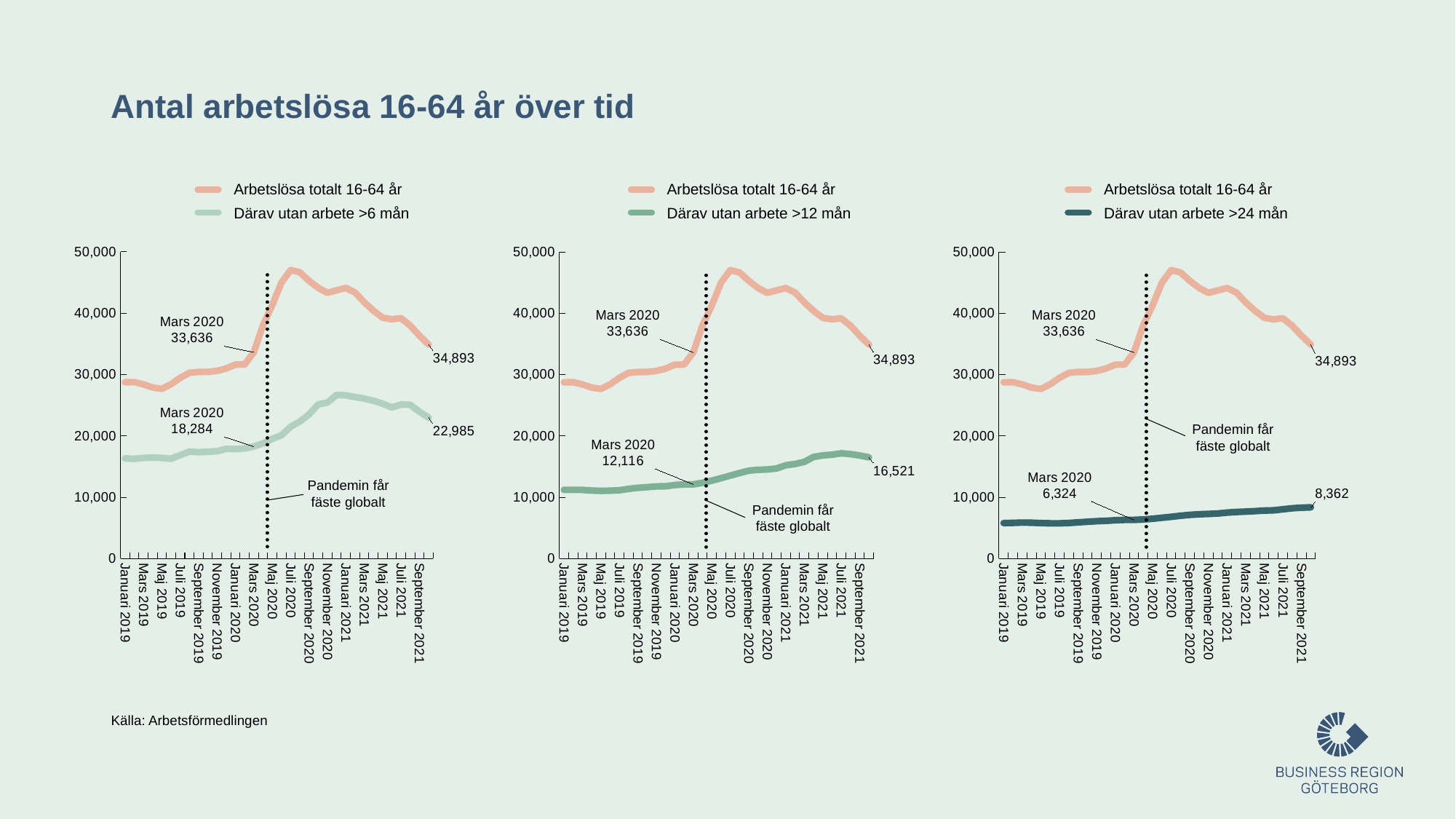
On the middle chart (Därav utan arbete >12 mån), what is the final labelled value of the 'Därav utan arbete >12 mån' line? 16,521 On the left chart (Därav utan arbete >6 mån), what is the value for 'Därav utan arbete >6 mån' in Mars 2020? 18,284 How many series does the legend of the right chart list? 2 On the middle chart, what is the difference between the final labelled values of 'Arbetslösa totalt 16-64 år' (34,893) and 'Därav utan arbete >12 mån' (16,521)? 18,372 On the right chart, by how much did 'Därav utan arbete >24 mån' increase from Mars 2020 (6,324) to its final labelled value (8,362)? 2,038 On the right chart (Därav utan arbete >24 mån), what is the value for 'Därav utan arbete >24 mån' in Mars 2020? 6,324 On the left chart, is the value for 'Arbetslösa totalt 16-64 år' in Juli 2020 greater or less than 40,000? greater On the middle chart, which is larger for 'Därav utan arbete >12 mån': the Mars 2020 value or the final labelled value? The final labelled value (16,521) On the left chart, what is the value for 'Arbetslösa totalt 16-64 år' in Mars 2020? 33,636 What kind of chart is used on this slide? Line chart On the left chart, what is the difference between the final labelled values of 'Arbetslösa totalt 16-64 år' (34,893) and 'Därav utan arbete >6 mån' (22,985)? 11,908 On the right chart, does the 'Därav utan arbete >24 mån' line rise or fall from Januari 2019 to September 2021? Rise